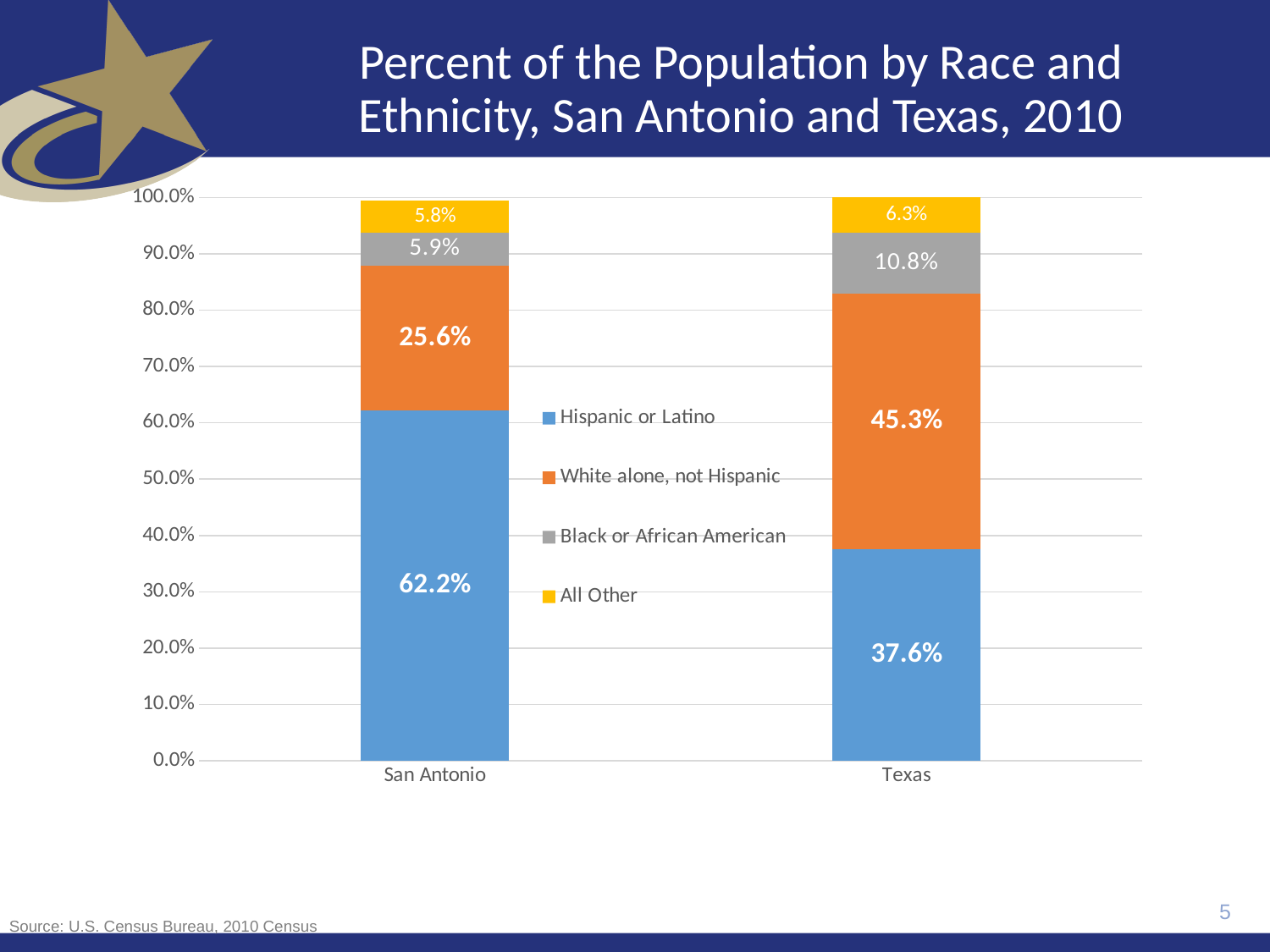
Which group has the largest share of the San Antonio population? Hispanic or Latino What is the All Other share for San Antonio? 5.8% What is the difference between the Black or African American shares of Texas and San Antonio? 4.9 percentage points Is the White alone, not Hispanic share larger in San Antonio or in Texas? Texas What is the total of the stacked bar for Texas? 100.0% What percent of the San Antonio population is Hispanic or Latino? 62.2% Which group has the largest share of the Texas population? White alone, not Hispanic What percent of the Texas population is White alone, not Hispanic? 45.3% What is the Black or African American share for Texas? 10.8% How many percentage points higher is the Hispanic or Latino share in San Antonio than in Texas? 24.6 What type of chart is shown on the slide? Stacked bar chart How many series does the legend list? 4